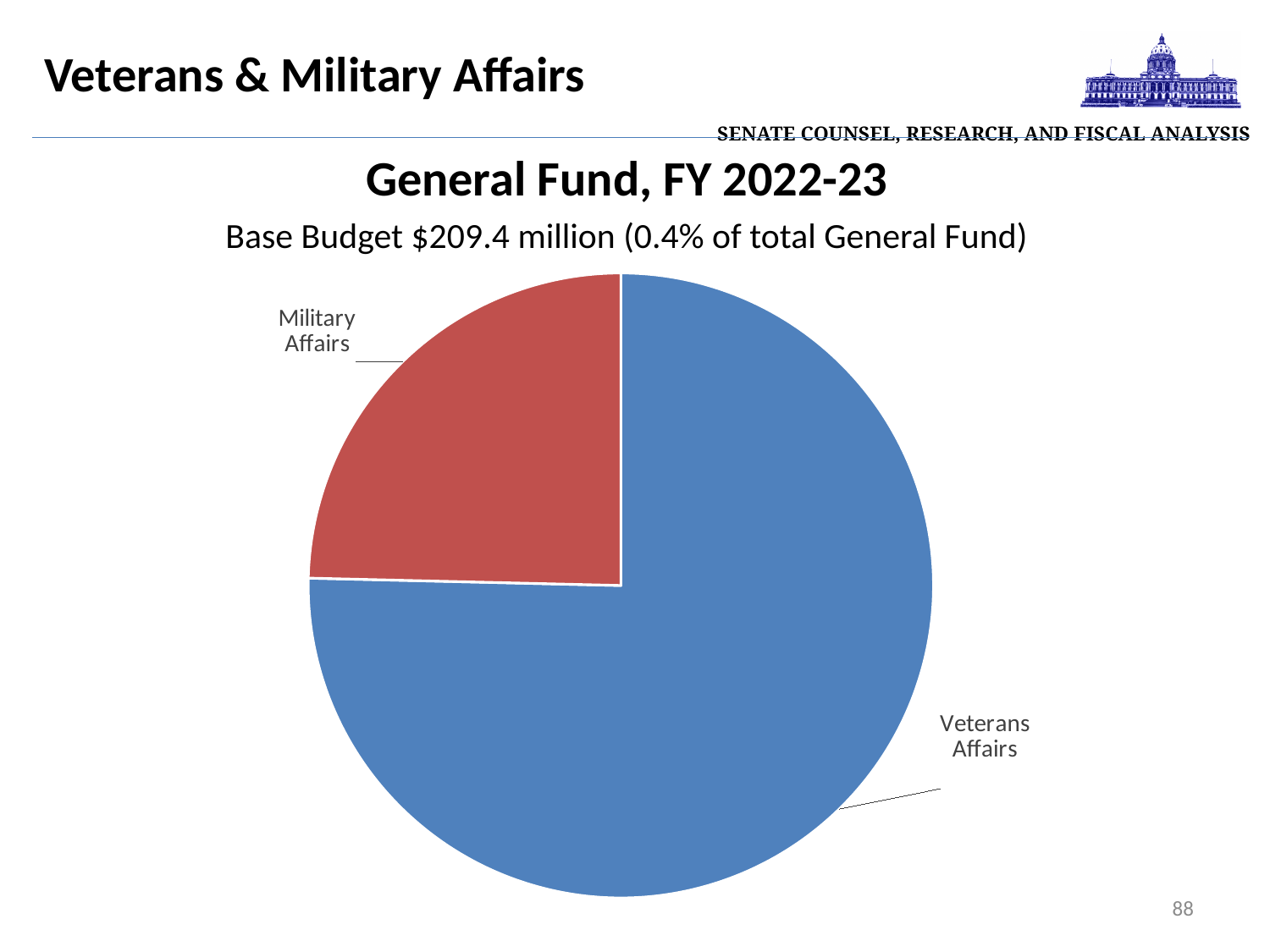
How many slices does the pie chart have? 2 Which is larger in the pie chart, Veterans Affairs or Military Affairs? Veterans Affairs Which category has the smallest share of the pie chart? Military Affairs What kind of chart is shown on the slide? pie chart What is the title of the chart? General Fund, FY 2022-23 What colour is the Military Affairs slice? red Which category has the largest share of the pie chart? Veterans Affairs